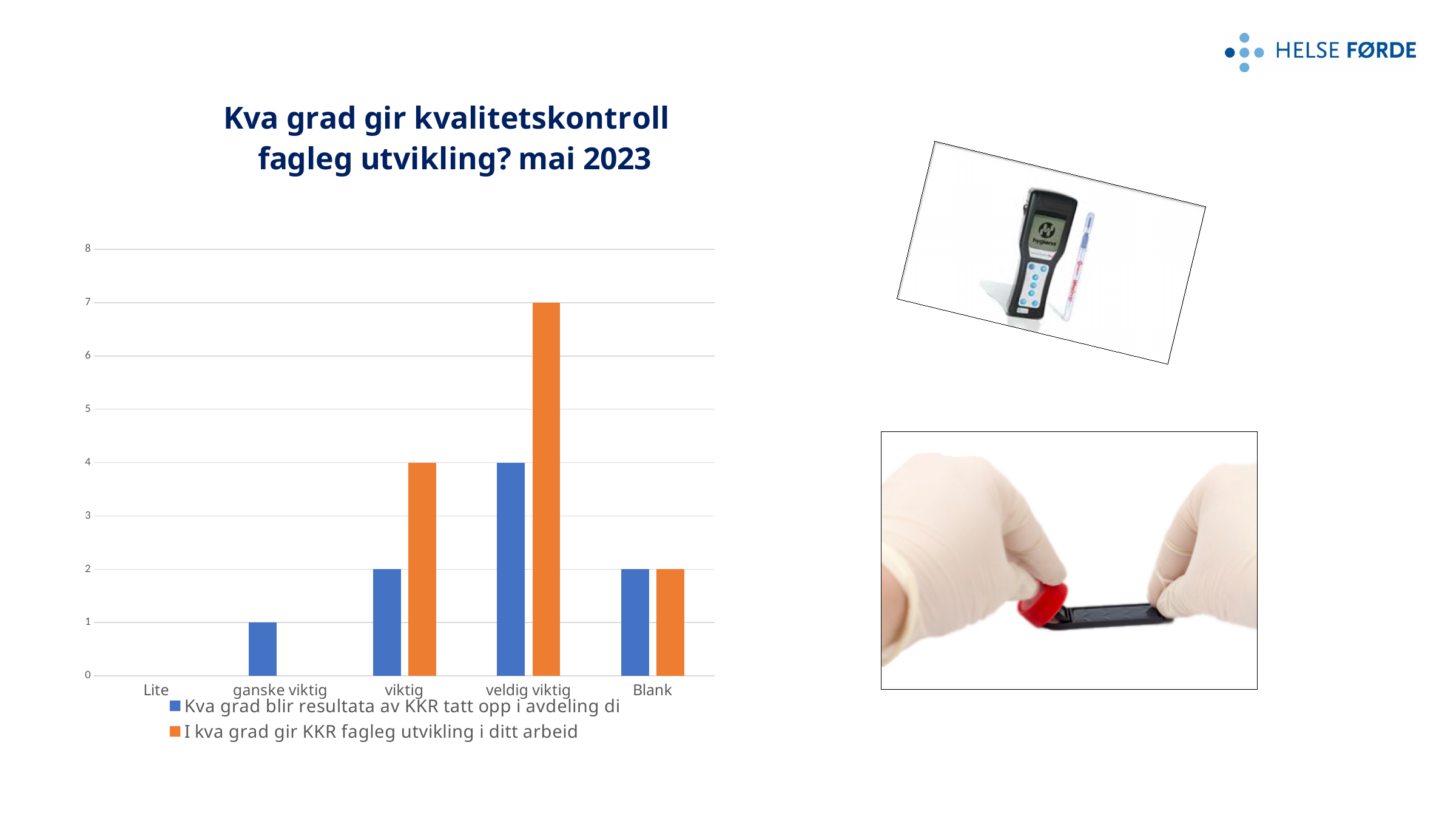
What is the value for 'ganske viktig' in the series 'Kva grad blir resultata av KKR tatt opp i avdeling di'? 1 What is the title of the chart? Kva grad gir kvalitetskontroll fagleg utvikling? mai 2023 For 'viktig', which series has the larger value? I kva grad gir KKR fagleg utvikling i ditt arbeid What is the value for 'veldig viktig' in the series 'Kva grad blir resultata av KKR tatt opp i avdeling di'? 4 What kind of chart is shown on the slide? bar chart How many categories are shown on the x axis? 5 Is the value for 'veldig viktig' in the series 'I kva grad gir KKR fagleg utvikling i ditt arbeid' greater or less than 6? greater What is the difference between the two series for 'veldig viktig'? 3 How many series does the legend list? 2 Which category has the highest value in the series 'I kva grad gir KKR fagleg utvikling i ditt arbeid'? veldig viktig What is the value for 'viktig' in the series 'I kva grad gir KKR fagleg utvikling i ditt arbeid'? 4 What is the value for 'veldig viktig' in the series 'I kva grad gir KKR fagleg utvikling i ditt arbeid'? 7